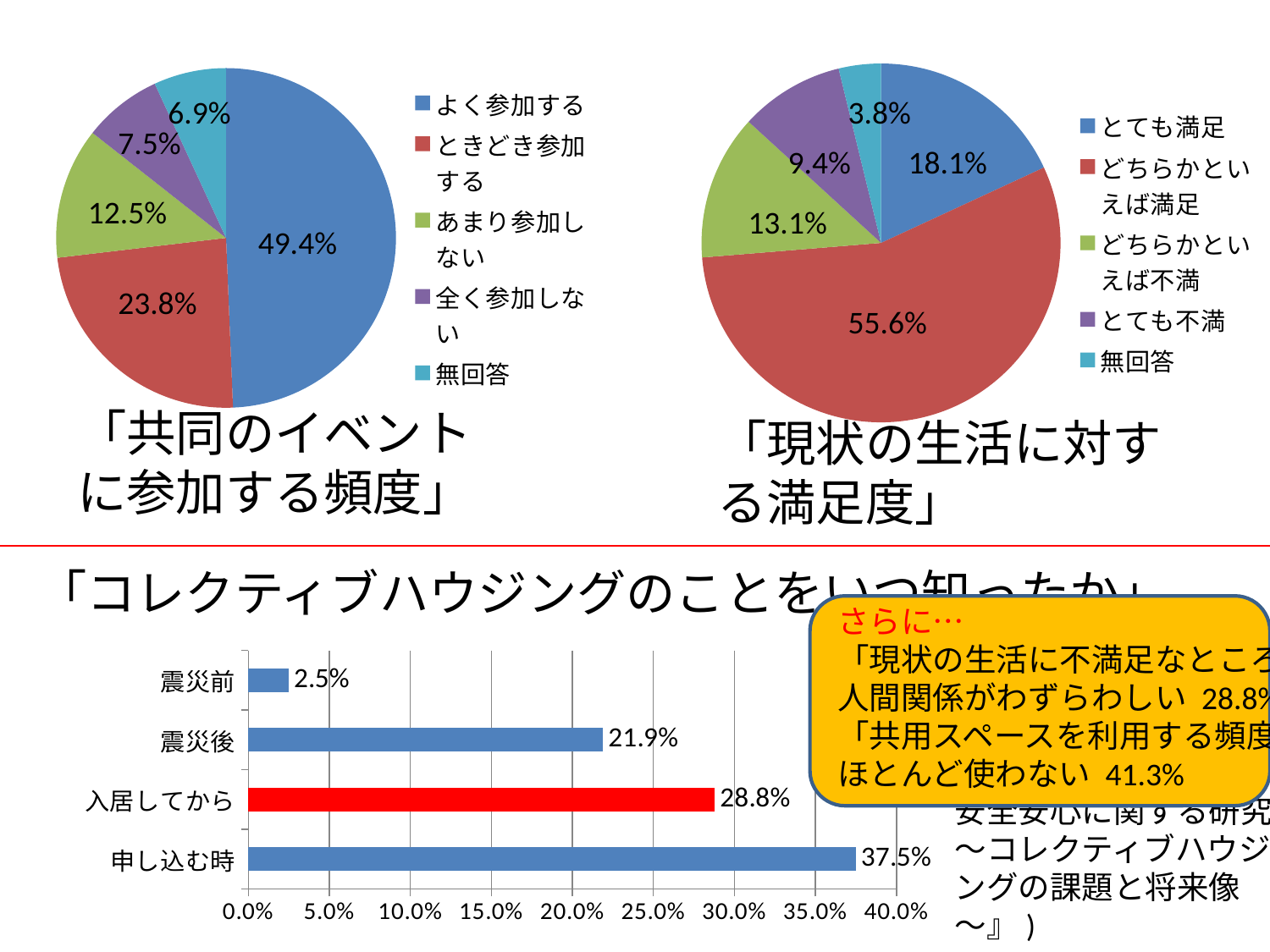
In the bar chart titled 「コレクティブハウジングのことをいつ知ったか」, what is the value for 入居してから? 28.8% In the pie chart titled 「共同のイベントに参加する頻度」, what share is labelled for よく参加する? 49.4% In the pie chart titled 「現状の生活に対する満足度」, which category has the largest slice? どちらかといえば満足 In the pie chart titled 「現状の生活に対する満足度」, what share is labelled for どちらかといえば満足? 55.6% What kind of chart is the chart titled 「コレクティブハウジングのことをいつ知ったか」 at the bottom of the slide? Bar chart In the bar chart titled 「コレクティブハウジングのことをいつ知ったか」, which category has the highest value? 申し込む時 In the pie chart titled 「共同のイベントに参加する頻度」, which category has the smallest slice? 無回答 In the pie chart titled 「共同のイベントに参加する頻度」, what is the difference between ときどき参加する and あまり参加しない? 11.3% In the pie chart titled 「現状の生活に対する満足度」, what share is labelled for 無回答? 3.8% In the bar chart titled 「コレクティブハウジングのことをいつ知ったか」, what is the difference between 申し込む時 and 震災後? 15.6% In the pie chart titled 「現状の生活に対する満足度」, which is larger, とても満足 or とても不満? とても満足 How many legend entries does the pie chart titled 「共同のイベントに参加する頻度」 list? 5